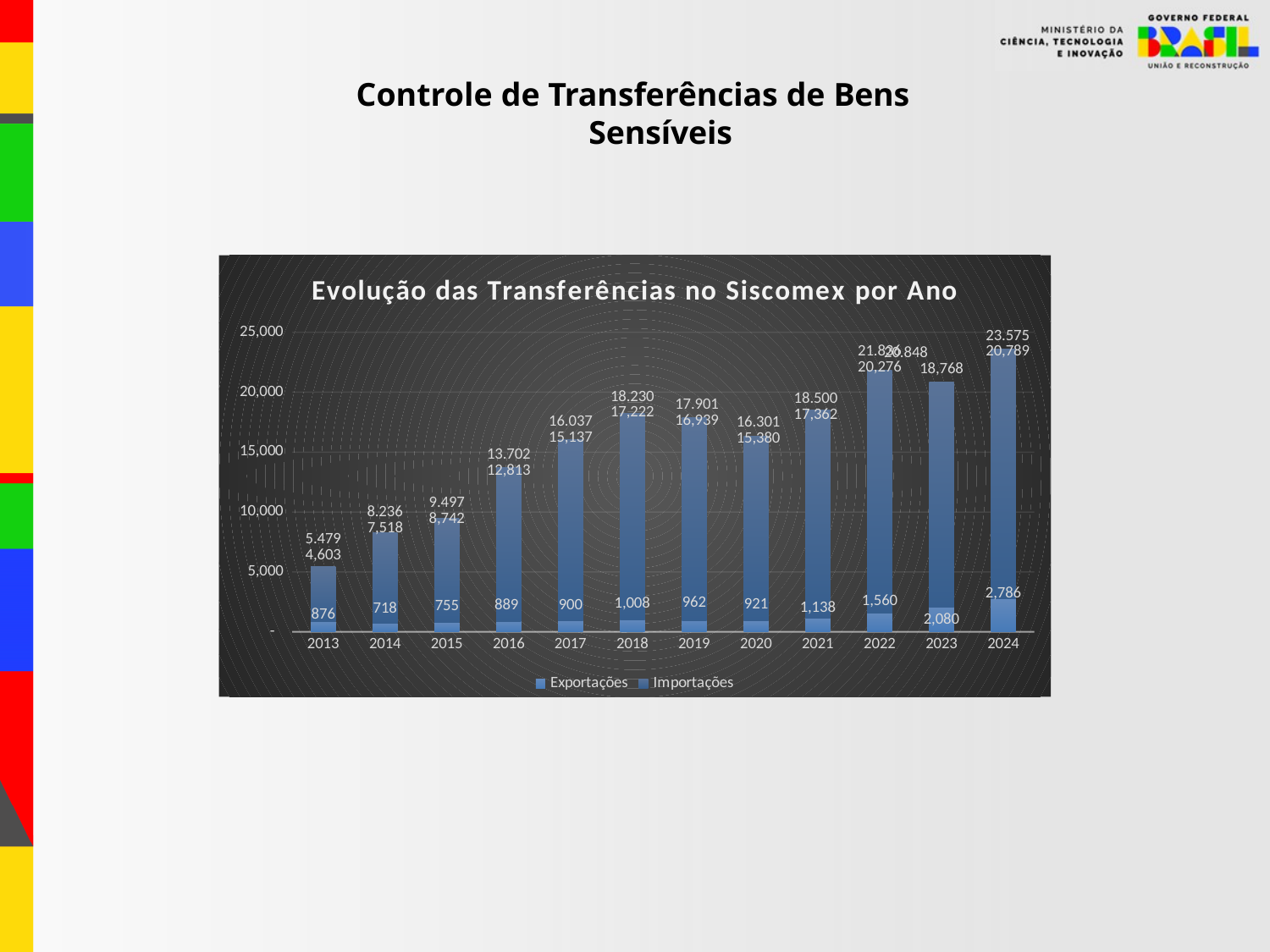
Which year has the highest Exportações value? 2024 What is the value of Importações for 2018? 17,222 What is the total of the stacked bar for 2017? 16.037 What is the value of Exportações for 2014? 718 What is the difference between the Importações values for 2022 and 2023? 1,508 What is the value of Exportações for 2024? 2,786 What type of chart is shown on the slide? stacked bar chart How many years are shown on the x axis? 12 What is the title of the chart? Evolução das Transferências no Siscomex por Ano How many series does the legend list? 2 Is the Importações value for 2020 greater or less than 15,000? greater Which year has the lowest Importações value? 2013